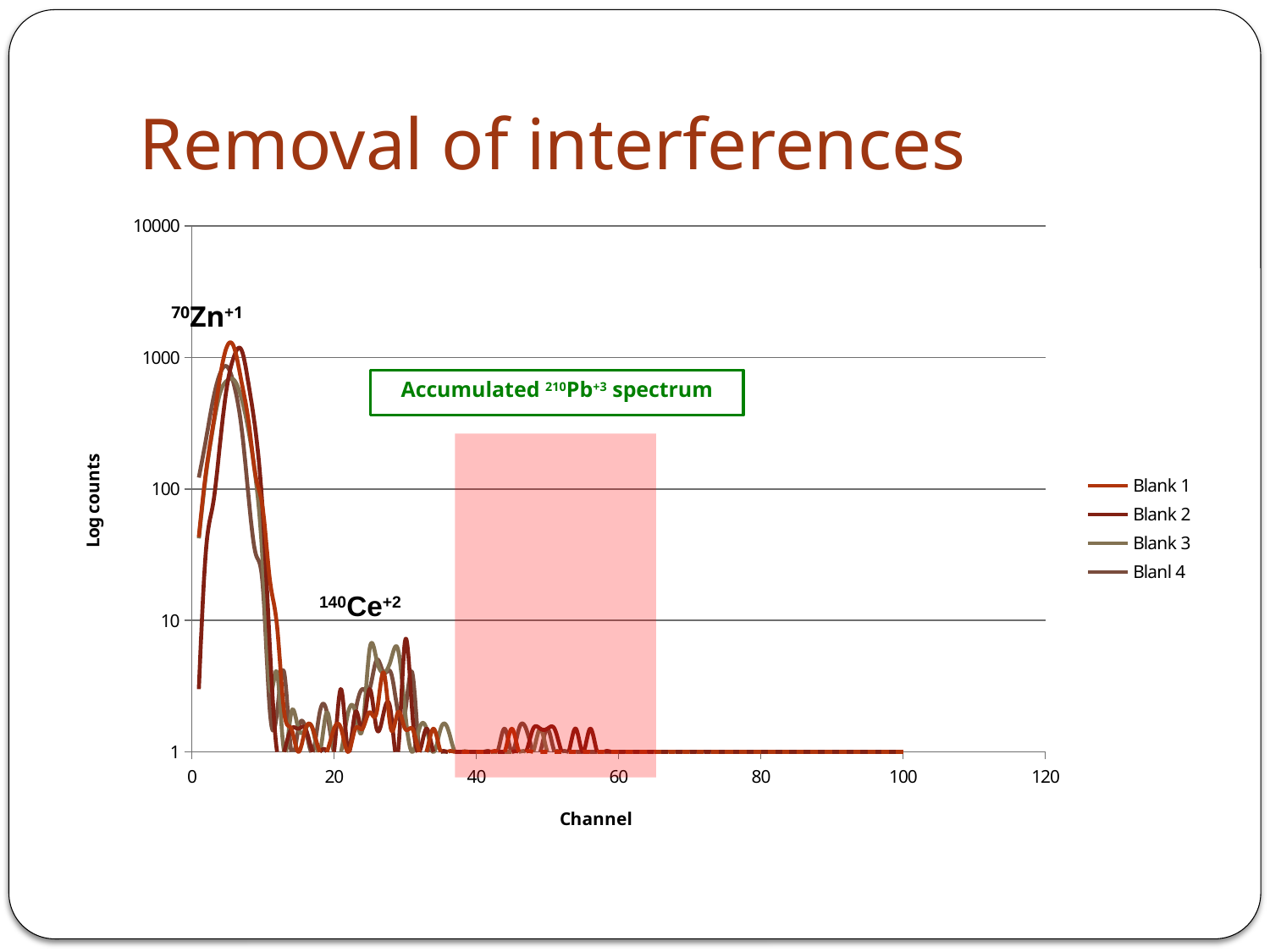
Do the values of Blank 1 rise or fall between channel 1 and channel 5? rise Is the peak value of Blank 1 near channel 5 greater or less than 100? greater Do the values of Blank 1 rise or fall between channel 10 and channel 15? fall Is the value of Blank 1 at channel 100 greater or less than 10? less Is the value of Blank 1 at channel 1 greater or less than 10? greater What is the title of the x axis? Channel What are the series names listed in the legend? Blank 1, Blank 2, Blank 3, Blanl 4 What kind of chart is shown on the slide? line chart How many series does the legend list? 4